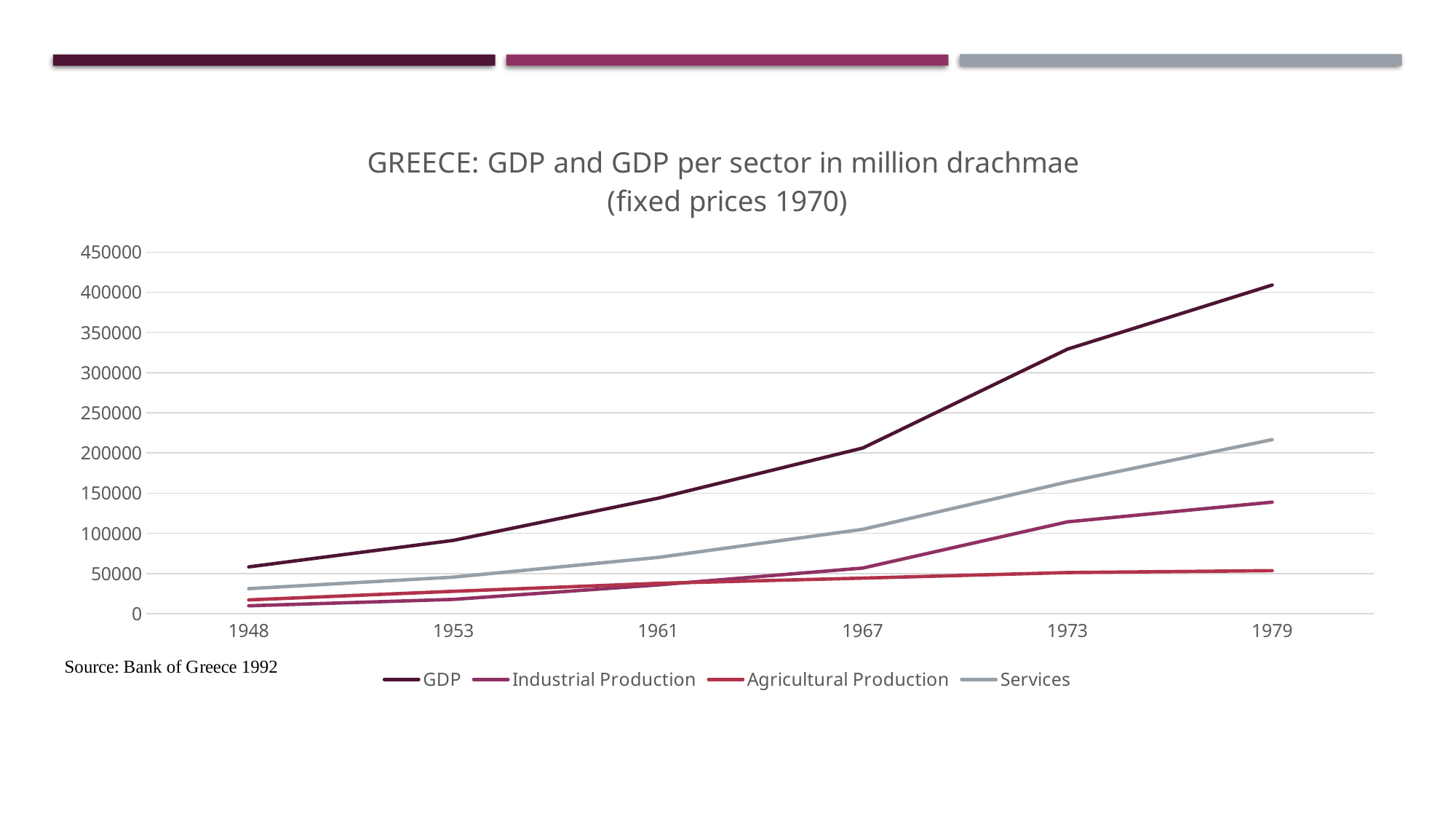
Is the GDP value for 1979 greater or less than 350000? greater Which series has the lowest value in 1979? Agricultural Production In 1979, which is larger: Services or Industrial Production? Services What source is cited for the chart? Bank of Greece 1992 Does the GDP line rise or fall from 1948 to 1979? rises What kind of chart is shown on the slide? line chart How many years are shown on the x axis? 6 How many series does the legend list? 4 Is the Services value for 1979 greater or less than 200000? greater Which series has the highest value in 1979? GDP Is the Industrial Production value for 1979 greater or less than 150000? less In 1948, which is larger: Agricultural Production or Industrial Production? Agricultural Production